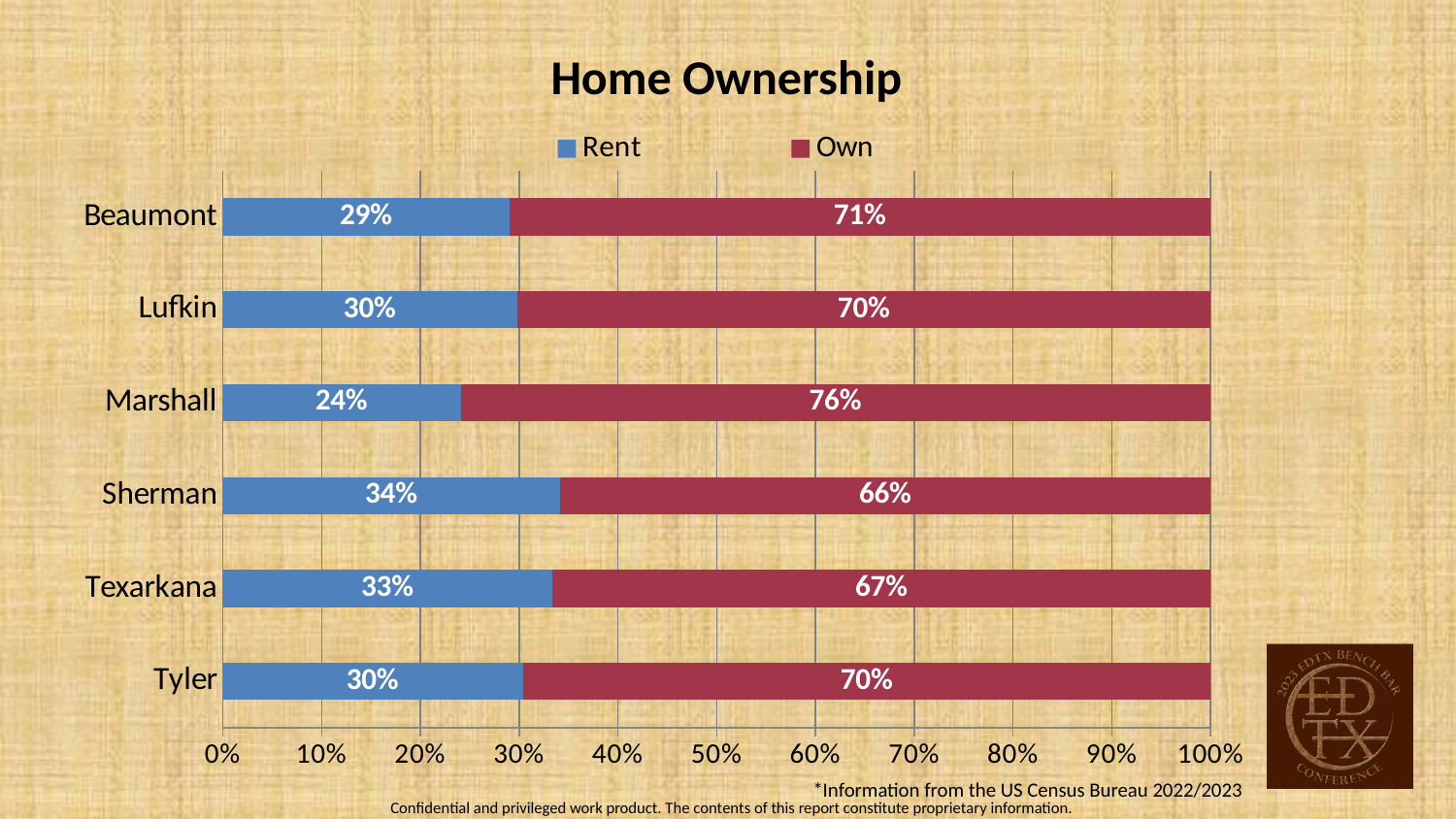
How many series does the legend list? 2 What is the Rent value for Beaumont? 29% What is the Own value for Marshall? 76% Which city has the highest Rent percentage? Sherman Which is larger, the Rent value for Sherman or the Rent value for Lufkin? Sherman What is the difference between the Own and Rent values for Tyler? 40% What type of chart is shown? Stacked bar chart How many cities are shown on the chart? 6 Which city has the lowest Rent percentage? Marshall Which city has the highest Own percentage? Marshall What is the Own value for Texarkana? 67% What is the Rent value for Sherman? 34%